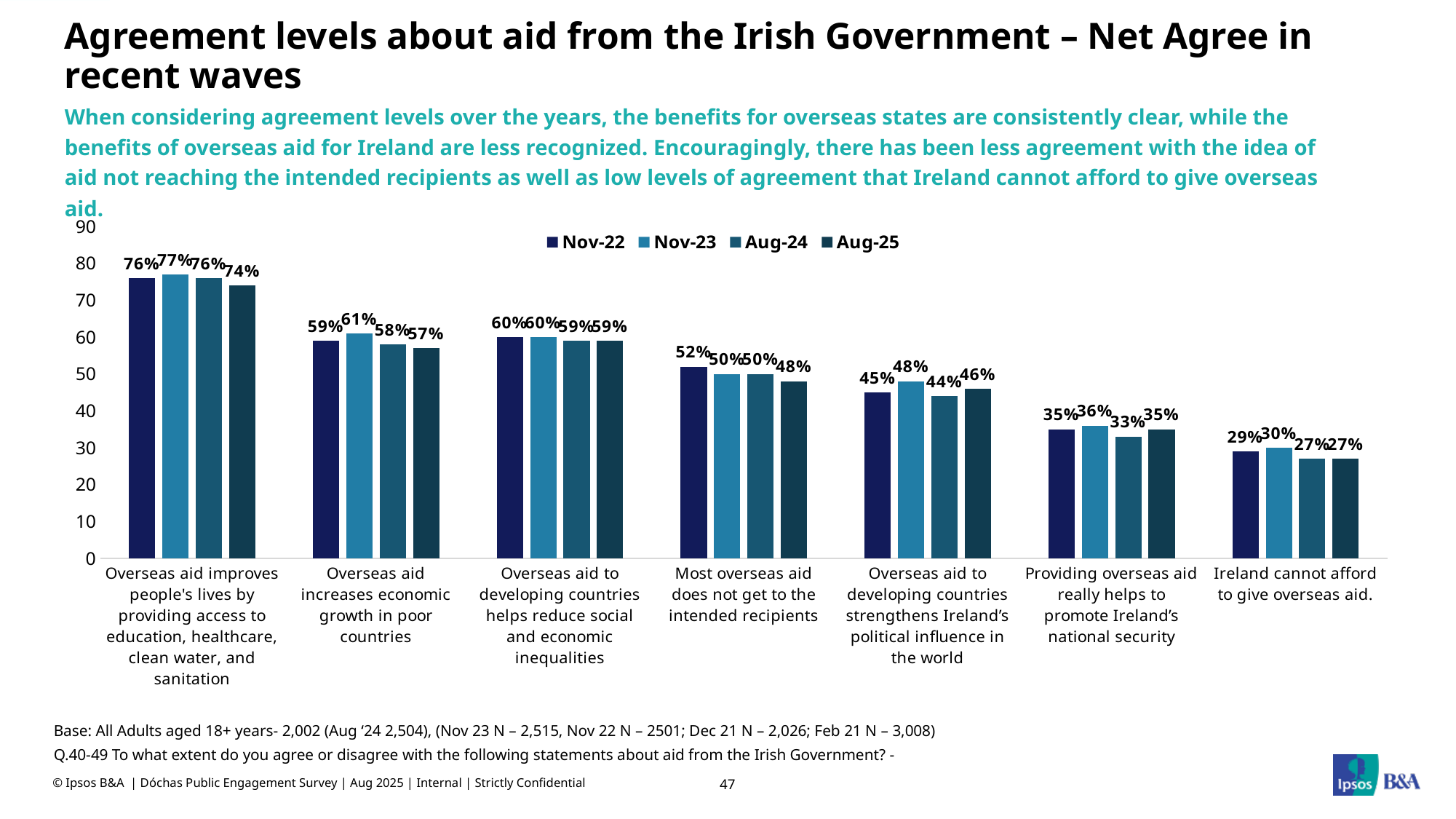
What are the four series listed in the legend? Nov-22, Nov-23, Aug-24, Aug-25 What is the Aug-24 value for 'Providing overseas aid really helps to promote Ireland's national security'? 33% Which statement has the highest Nov-22 value? Overseas aid improves people's lives by providing access to education, healthcare, clean water, and sanitation How many statements (categories) are shown on the x axis? 7 What kind of chart is shown on the slide? Bar chart How many series does the legend list? 4 What is the Aug-25 value for 'Overseas aid improves people's lives by providing access to education, healthcare, clean water, and sanitation'? 74% For 'Overseas aid to developing countries strengthens Ireland's political influence in the world', which is larger: the Nov-23 value or the Aug-24 value? Nov-23 What is the difference between the Nov-22 and Aug-25 values for 'Most overseas aid does not get to the intended recipients'? 4% What is the Nov-23 value for 'Overseas aid increases economic growth in poor countries'? 61% What is the Nov-22 value for 'Most overseas aid does not get to the intended recipients'? 52% Which statement has the lowest Aug-25 value? Ireland cannot afford to give overseas aid.